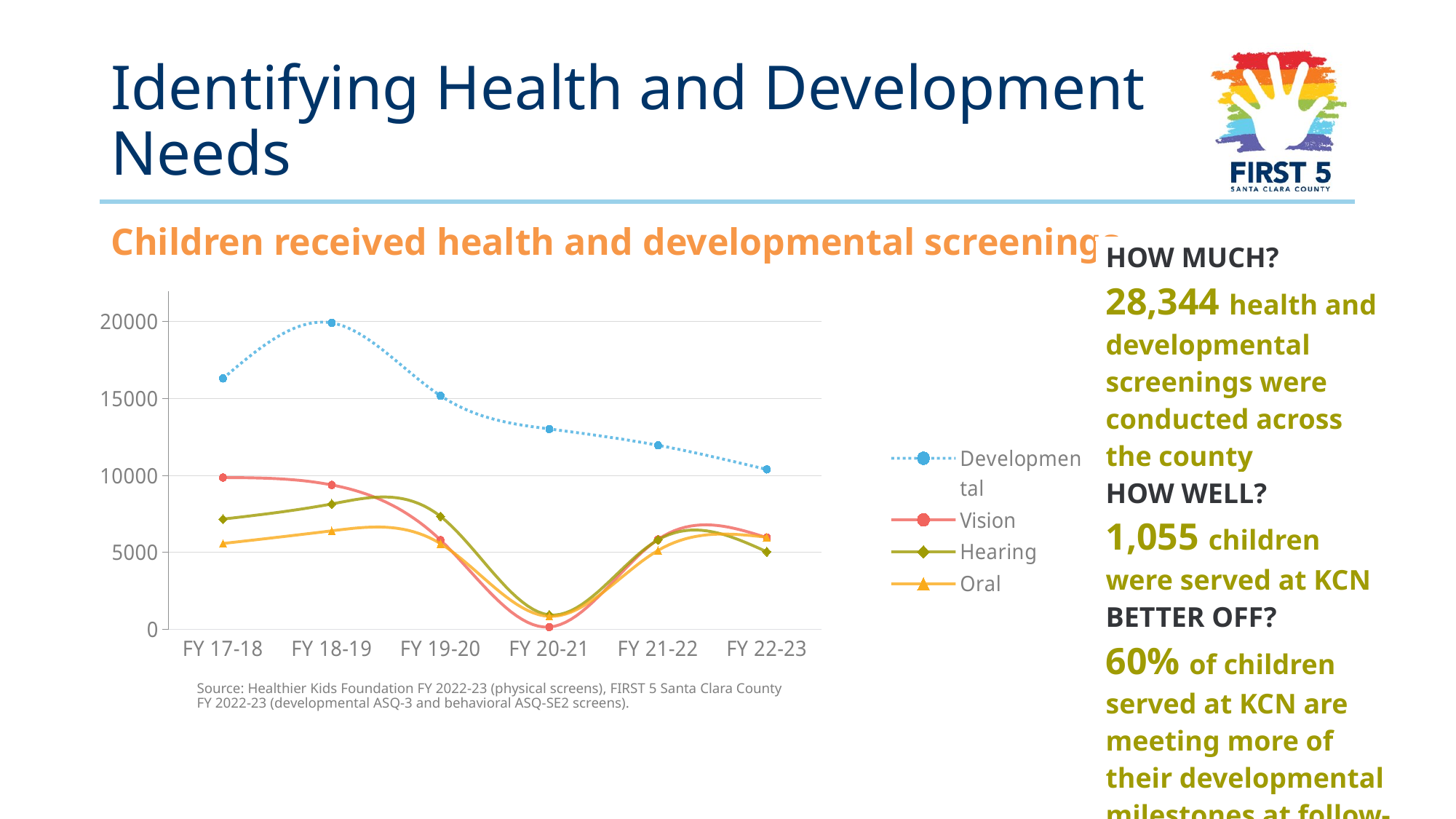
In which fiscal year is the Vision series at its lowest? FY 20-21 Is the Vision value for FY 20-21 greater or less than 5000? less What kind of chart is shown on the slide? line chart How many series does the chart legend list? 4 Which series is drawn with a dotted line in the chart? Developmental How many fiscal years are plotted along the x axis? 6 Which series has the higher value in FY 17-18, Developmental or Vision? Developmental Does the Developmental series rise or fall from FY 18-19 to FY 22-23? fall In which fiscal year is the Developmental series at its lowest? FY 22-23 Is the Developmental value for FY 20-21 greater or less than 15000? less In which fiscal year is the Developmental series at its highest? FY 18-19 Is the Developmental value for FY 18-19 greater or less than 15000? greater